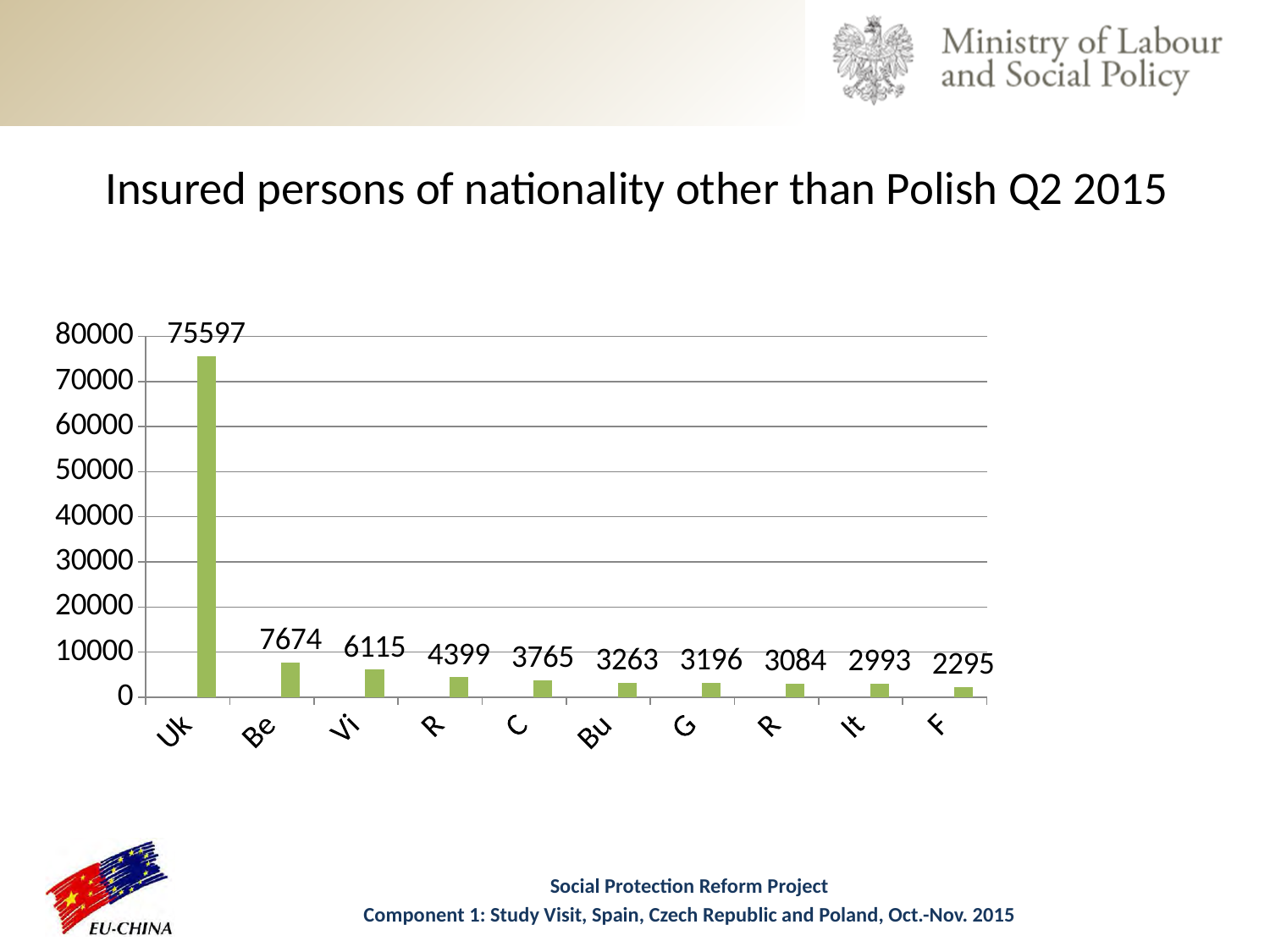
What is the difference between the values for "Be" and "Vi"? 1559 What is the value of the bar labelled "Be"? 7674 Do the values rise or fall from left to right along the x axis? fall How many bars (categories) does the chart show? 10 Which category has the highest value? Uk What is the title of the chart? Insured persons of nationality other than Polish Q2 2015 What is the value of the bar labelled "Bu"? 3263 Which is larger, the value for "Be" or the value for "It"? Be What is the value of the lowest bar, the last one on the right? 2295 What is the value of the bar labelled "Vi"? 6115 What kind of chart is shown on the slide? bar chart What is the value of the bar labelled "Uk"? 75597